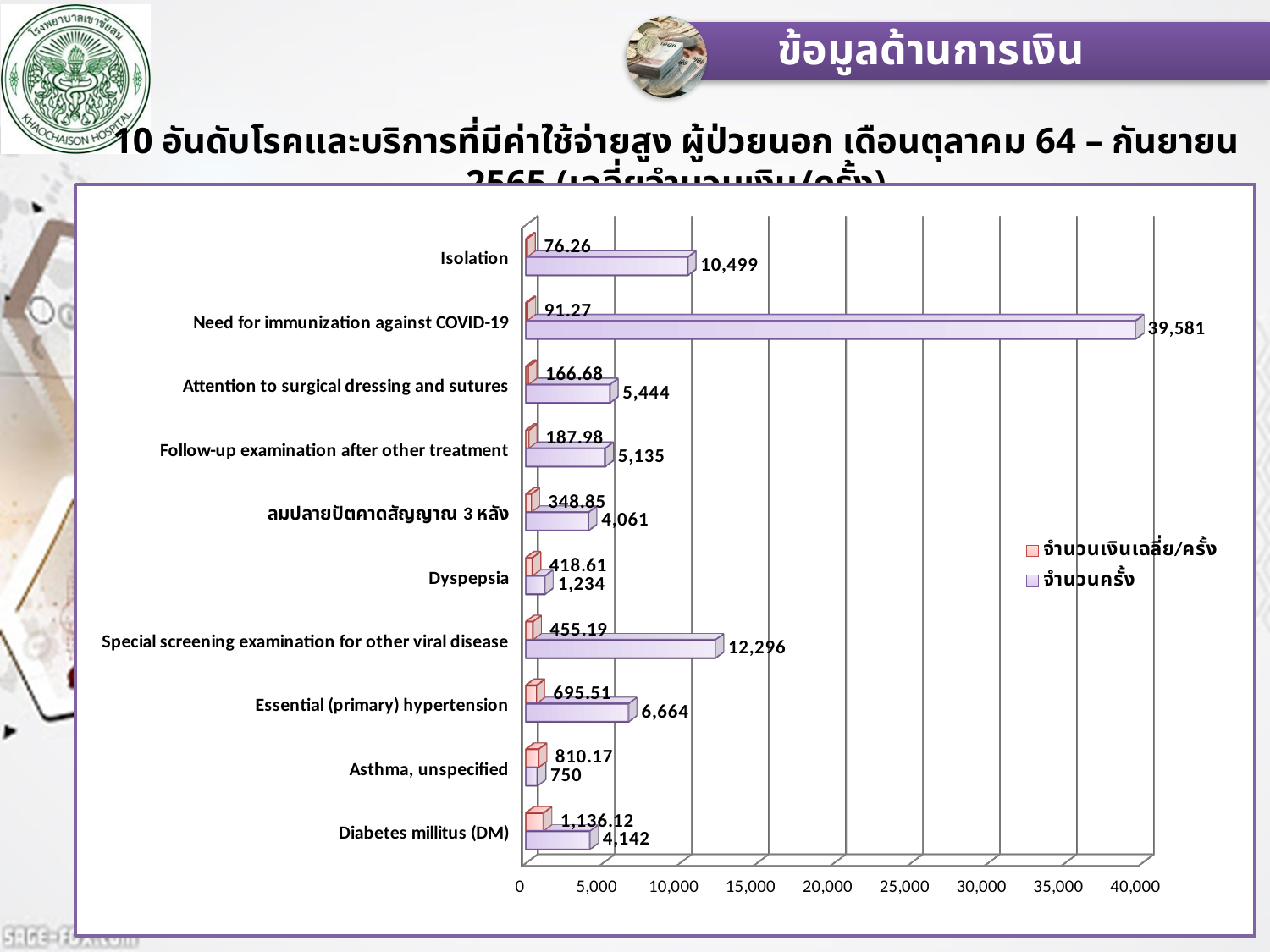
How many categories are shown on the chart? 10 What is the จำนวนครั้ง value for Need for immunization against COVID-19? 39,581 What is the จำนวนเงินเฉลี่ย/ครั้ง value for Diabetes millitus (DM)? 1,136.12 What kind of chart is shown on the slide? Bar chart Which category has the lowest จำนวนเงินเฉลี่ย/ครั้ง value? Isolation Which category has the lowest จำนวนครั้ง value? Asthma, unspecified What is the difference between the จำนวนครั้ง values for Isolation and Essential (primary) hypertension? 3,835 What is the จำนวนครั้ง value for Special screening examination for other viral disease? 12,296 Which has a larger จำนวนครั้ง value, Attention to surgical dressing and sutures or Follow-up examination after other treatment? Attention to surgical dressing and sutures What is the จำนวนเงินเฉลี่ย/ครั้ง value for Asthma, unspecified? 810.17 Which category has the highest จำนวนครั้ง value? Need for immunization against COVID-19 How many series does the legend list? 2